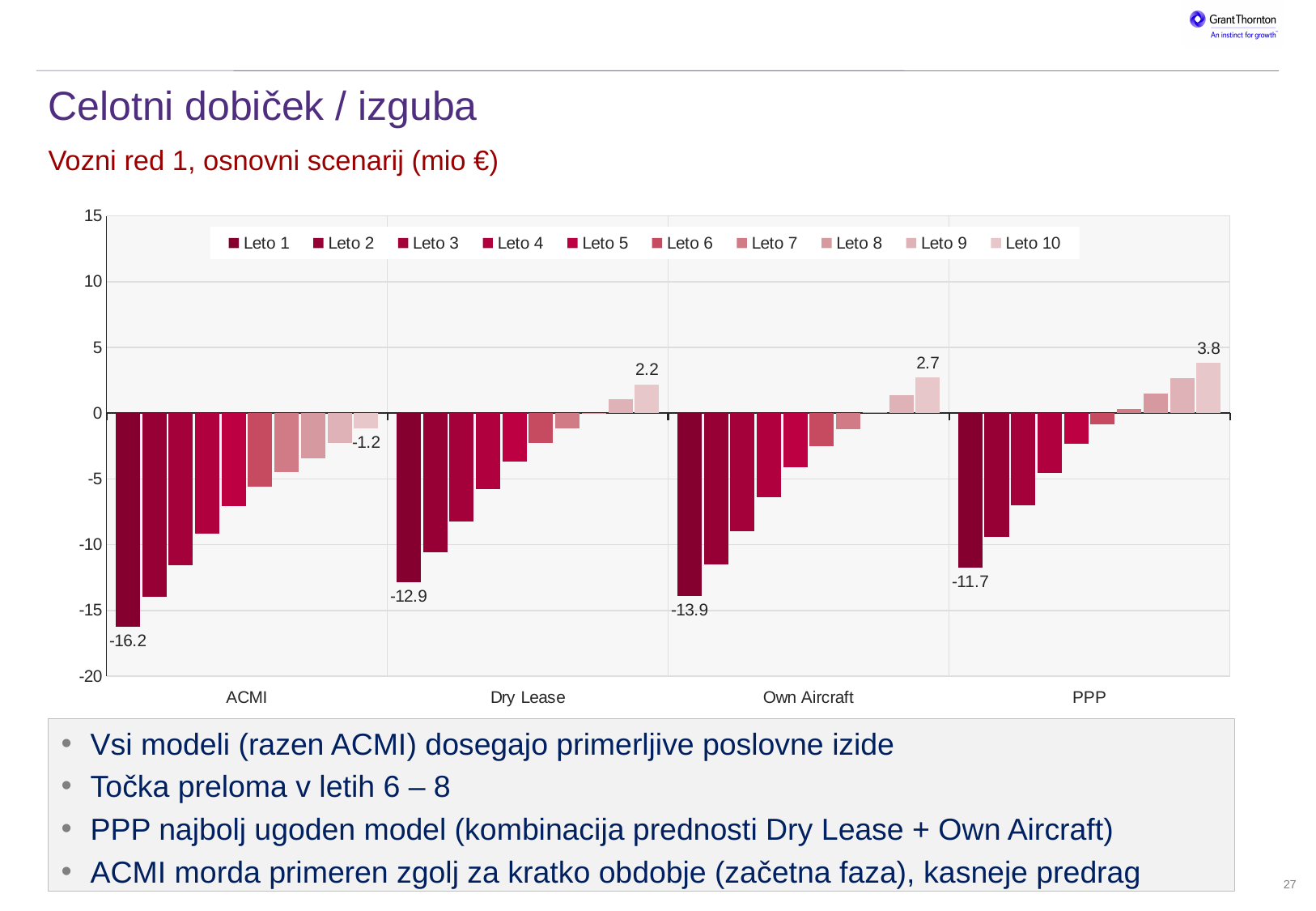
What is the value for Leto 10 in the Dry Lease category? 2.2 What is the value for Leto 1 in the Own Aircraft category? -13.9 Which category has the lowest Leto 1 value? ACMI What is the value for Leto 10 in the PPP category? 3.8 Which category has the highest Leto 10 value? PPP What kind of chart is shown on the slide? bar chart How many categories are shown on the x axis? 4 How many series does the legend list? 10 What is the value for Leto 1 in the ACMI category? -16.2 Is the value for Leto 5 in the ACMI category greater or less than -5? less Which is larger, the Leto 1 value for Dry Lease or the Leto 1 value for PPP? PPP What is the difference between the Leto 10 values for PPP and Own Aircraft? 1.1